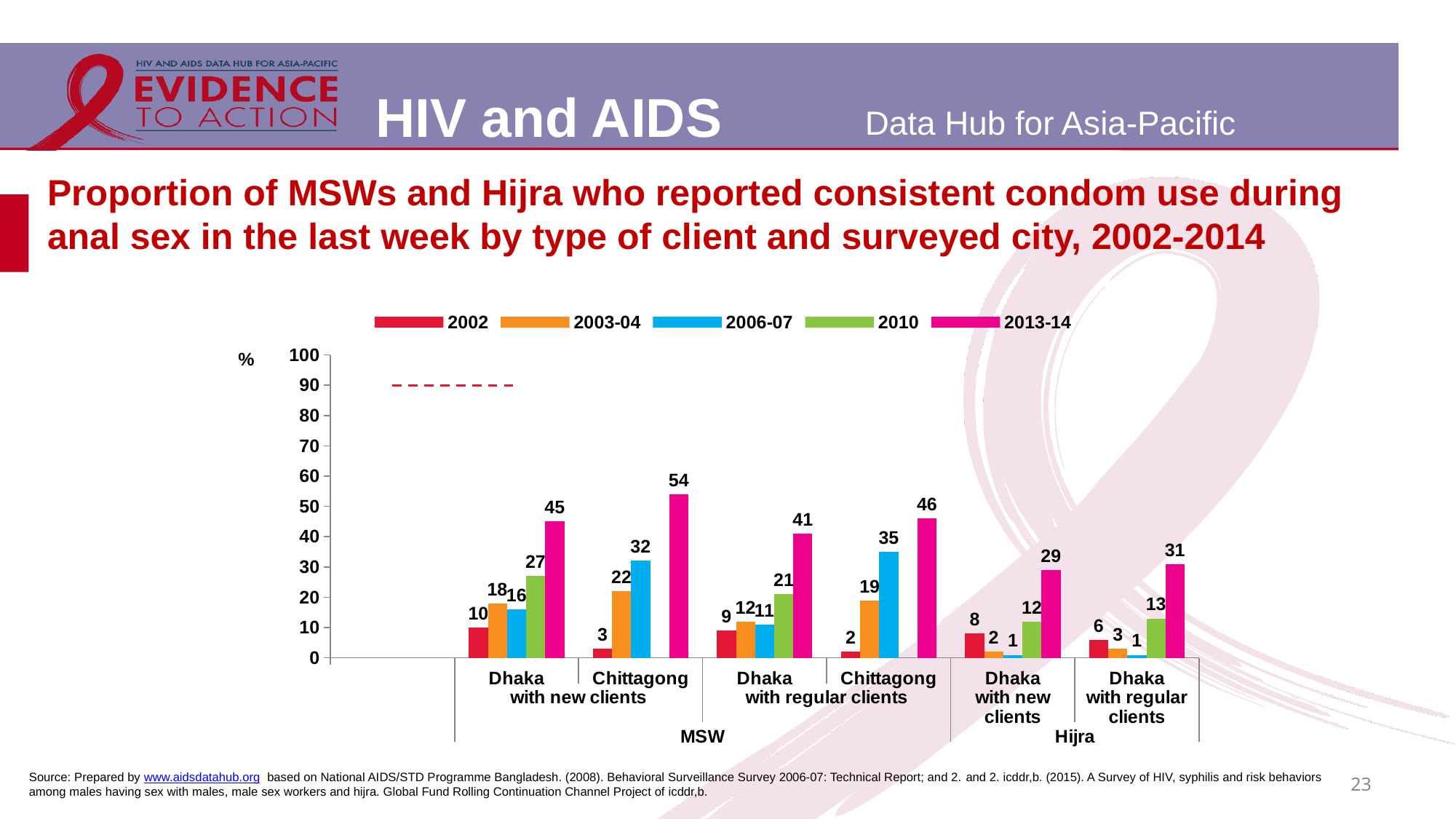
What is the 2002 value for MSW in Dhaka with new clients? 10 Do the values for MSW in Chittagong with new clients rise or fall across the survey periods from 2002 to 2013-14? Rise What kind of chart is shown on the slide? Bar chart For Hijra in Dhaka in 2013-14, which is larger: the value with new clients or with regular clients? Regular clients How many survey periods does the legend list? 5 What is the difference between the 2013-14 and 2002 values for MSW in Dhaka with new clients? 35 Which group has the highest value in the chart? Chittagong with new clients (MSW), 2013-14 How many city/client-type groups are shown along the x axis? 6 What is the 2010 value for Hijra in Dhaka with regular clients? 13 What is the 2006-07 value for MSW in Chittagong with regular clients? 35 Which group has the lowest 2013-14 value? Hijra in Dhaka with new clients What is the 2013-14 value for MSW in Chittagong with new clients? 54